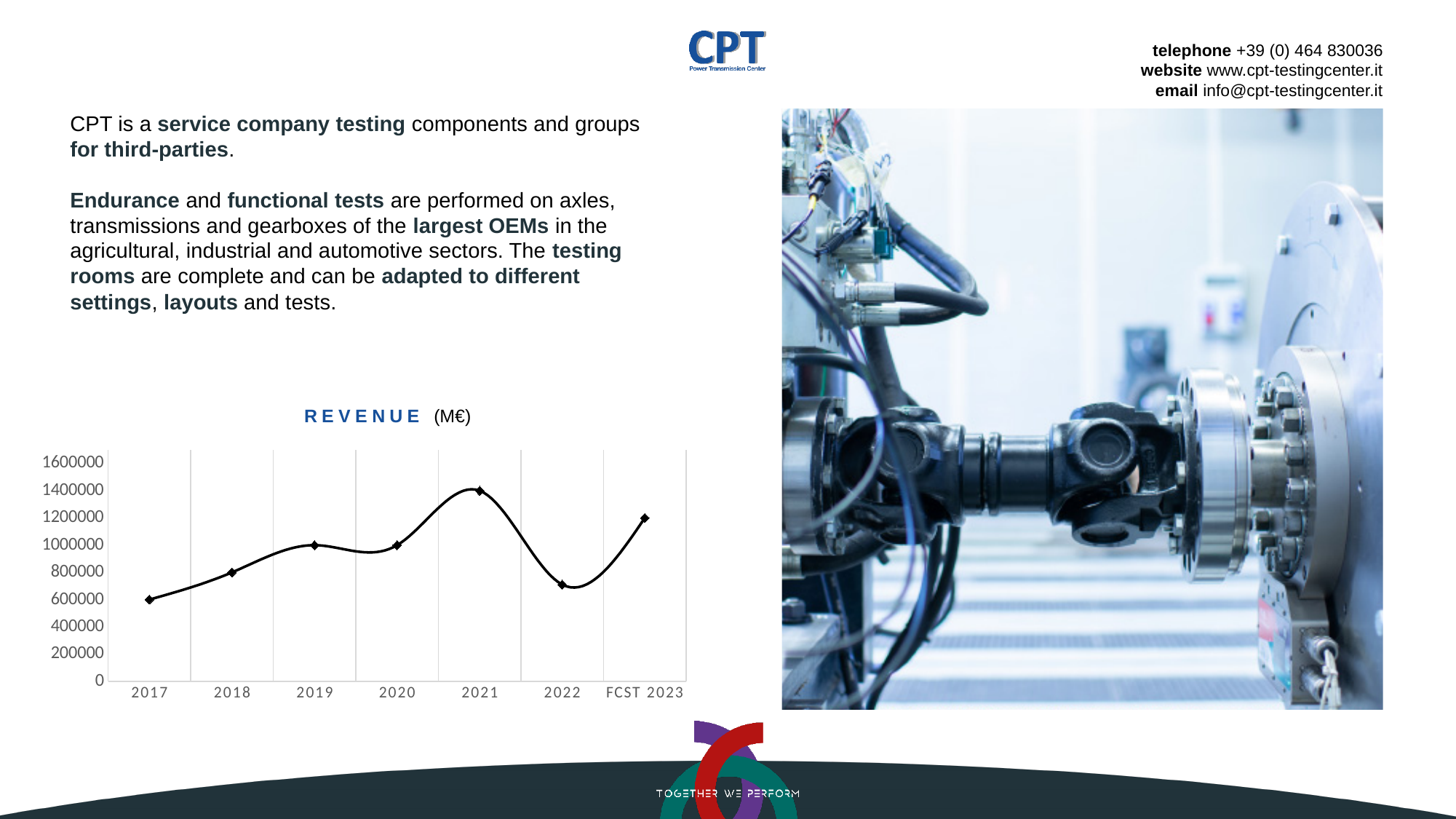
What is the title of the chart? REVENUE (M€) Which is larger, the revenue for 2017 or for 2018? 2018 Is the revenue for 2022 greater or less than 800000? less Is the revenue for FCST 2023 greater or less than 1000000? greater What kind of chart is shown on the slide? line chart Which year has the highest revenue on the chart? 2021 Which year has the lowest revenue on the chart? 2017 Is the revenue for 2017 greater or less than 400000? greater How many data points are plotted on the revenue chart? 7 Does the revenue rise or fall from 2017 to 2019? rise Which is larger, the revenue for 2021 or for 2022? 2021